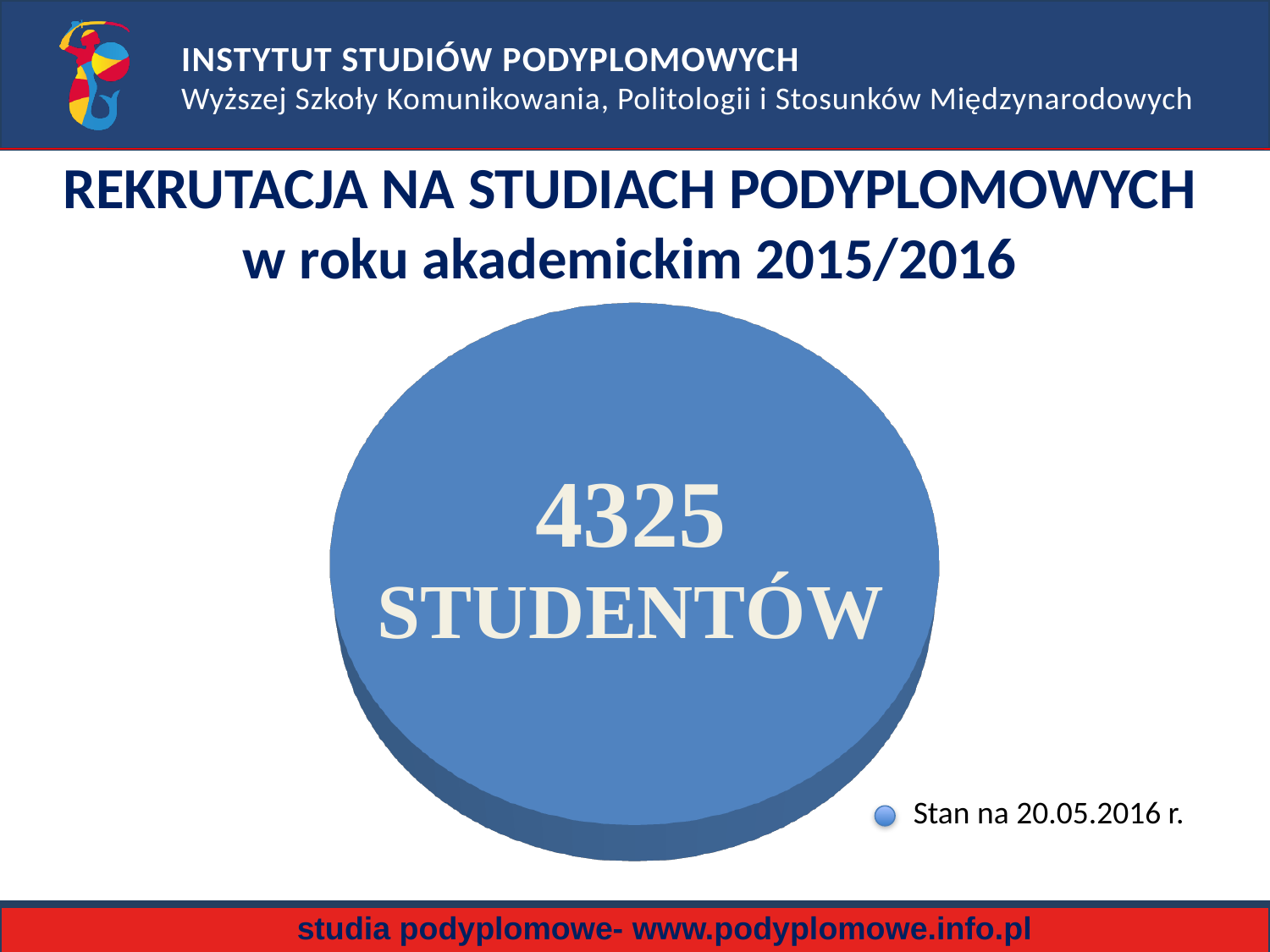
What value is printed on the pie chart's slice? 4325 STUDENTÓW How many entries does the chart legend list? 1 How many slices does the pie chart have? 1 Is the number of students shown on the pie chart greater or less than 4000? greater What is the legend entry shown next to the pie chart? Stan na 20.05.2016 r. What kind of chart is shown on the slide? pie chart What share of the pie does the single slice represent? 100% How many students does the pie chart report? 4325 What colour is the pie chart's slice? blue